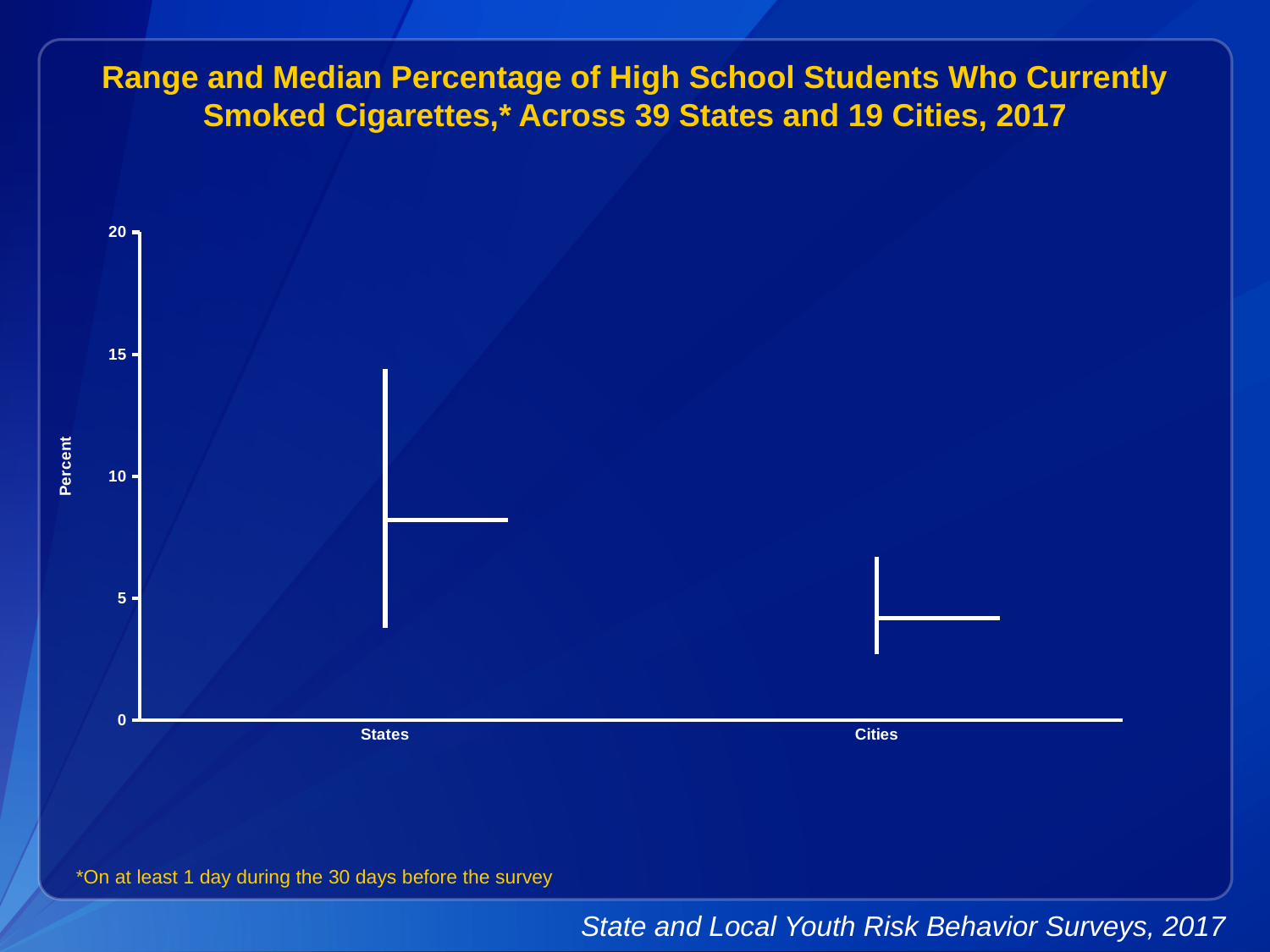
Which category has the higher median percentage, States or Cities? States Is the top of the range for Cities greater or less than 5? greater Which category has the highest median value? States Is the median value for States greater or less than 10? less Which category has the lowest median value? Cities Is the top of the range for States greater or less than 10? greater What are the two categories shown on the x axis? States and Cities How many categories are shown on the x axis of the chart? 2 What is the label on the y axis of the chart? Percent